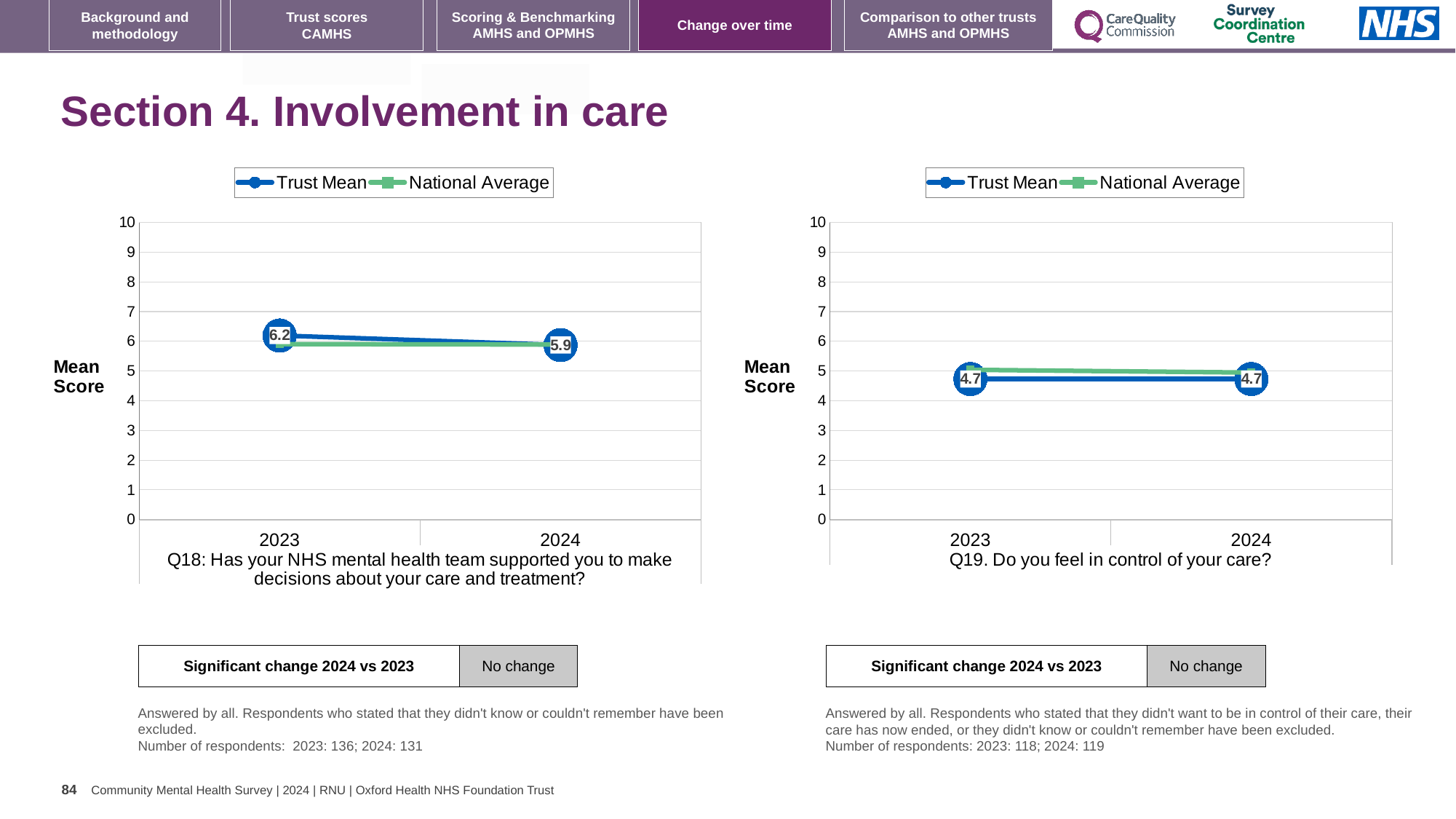
In the Q18 chart, what is the Trust Mean for 2024? 5.9 In the Q18 chart, by how much did the Trust Mean change from 2023 to 2024? 0.3 In the Q18 chart, does the Trust Mean rise or fall from 2023 to 2024? fall In the Q18 chart, is the Trust Mean higher in 2023 or 2024? 2023 In the Q19 chart, what is the Trust Mean for 2024? 4.7 How many series does the legend of the Q18 chart list? 2 In the Q18 chart, is the National Average for 2024 greater or less than 3? greater How many years are plotted on the x axis of the Q19 chart? 2 In the Q18 chart, what is the Trust Mean for 2023? 6.2 In the Q19 chart, is the National Average for 2023 greater or less than 7? less What kind of chart is the Q19 chart? line chart In the Q19 chart, does the Trust Mean rise, fall or stay the same from 2023 to 2024? stay the same